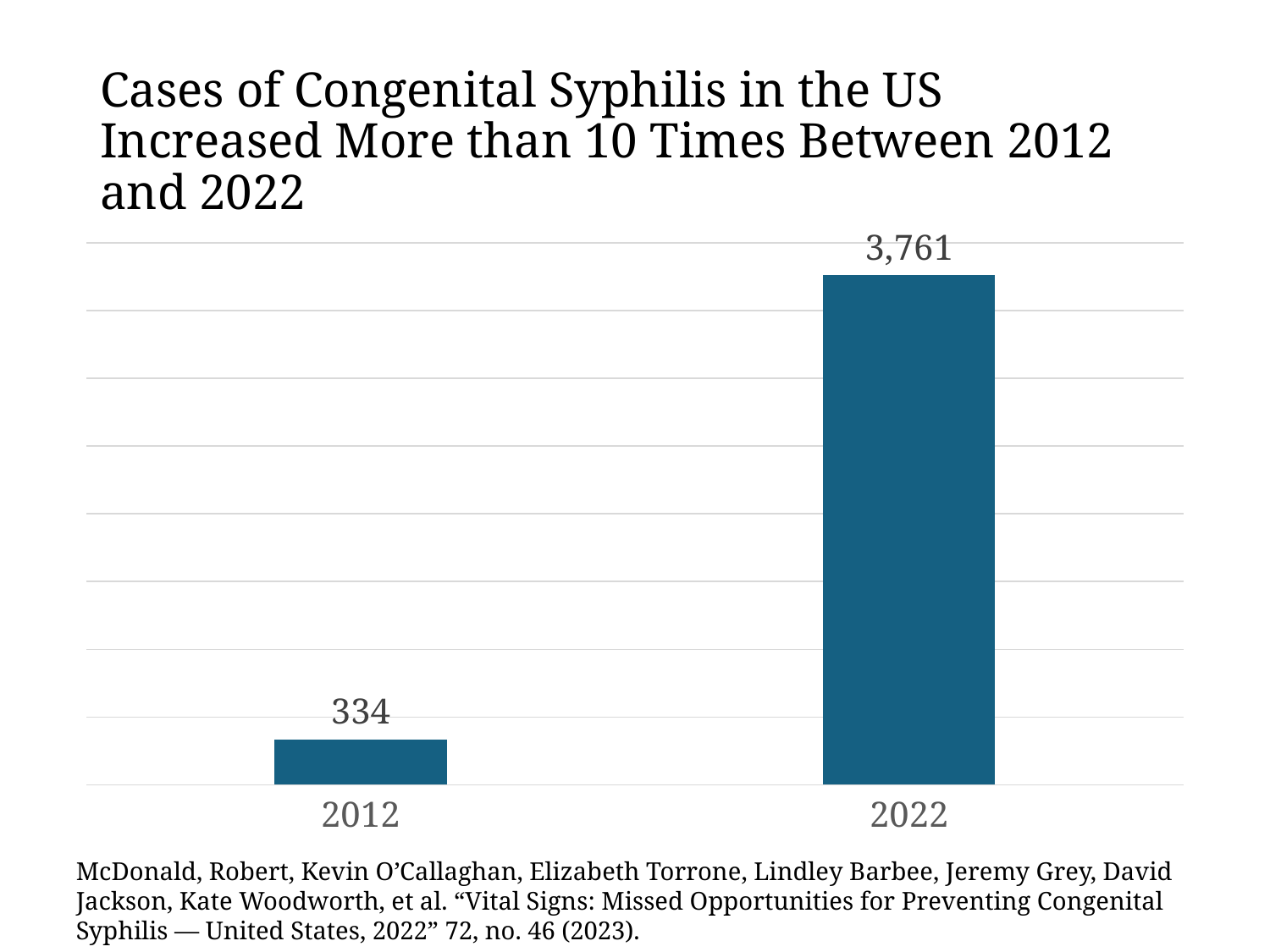
Which is larger, the value for 2012 or the value for 2022? 2022 What is the value for 2012? 334 Do the values rise or fall from 2012 to 2022? rise What is the difference between the values for 2022 and 2012? 3,427 What is the value for 2022? 3,761 Which year has the highest value? 2022 What kind of chart is shown on the slide? bar chart How many categories are shown on the x axis? 2 What colour are the bars in the chart? dark blue Which year has the lowest value? 2012 What is the title of the chart? Cases of Congenital Syphilis in the US Increased More than 10 Times Between 2012 and 2022